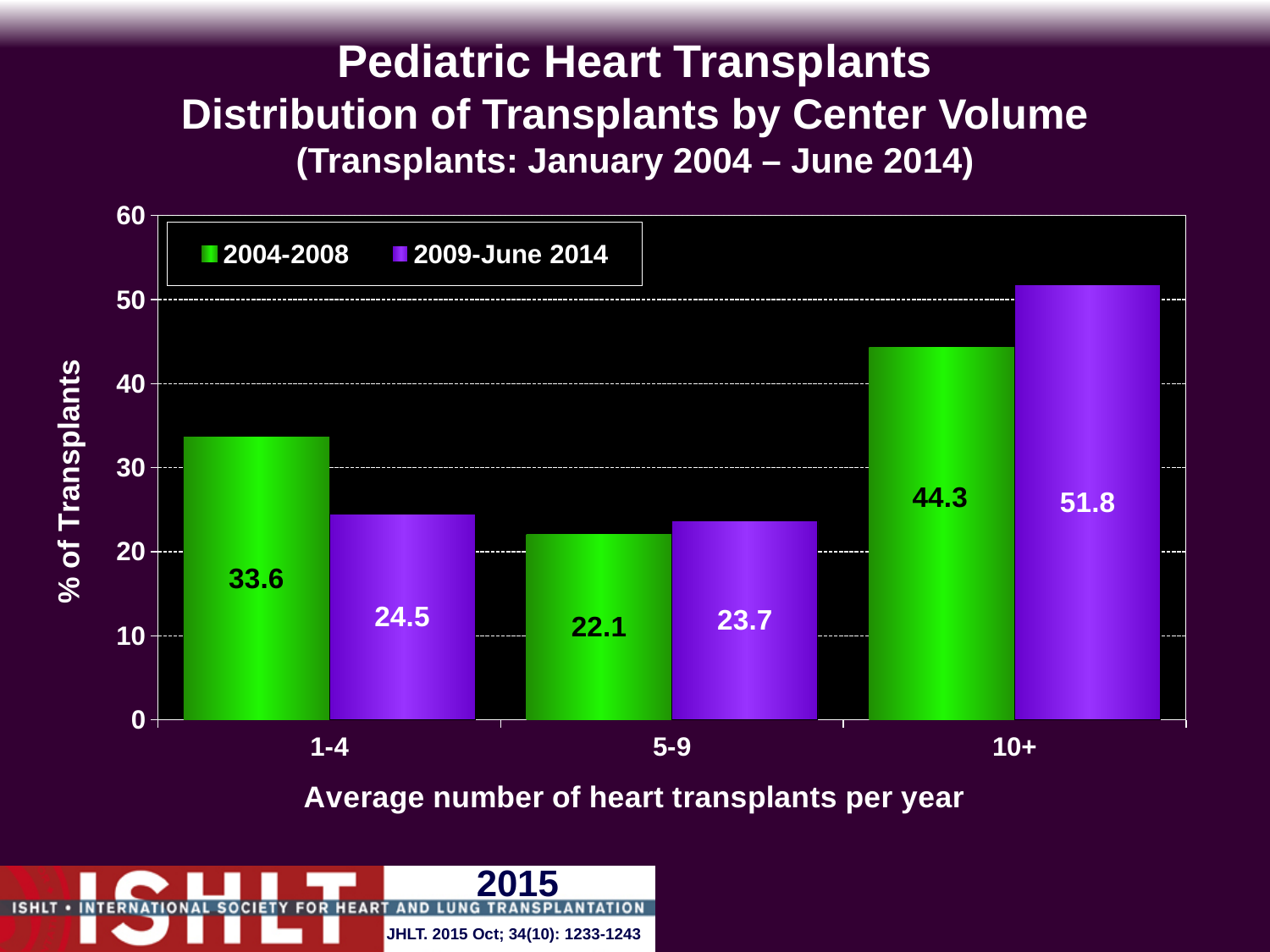
What is the value for the 10+ category in the 2009-June 2014 series? 51.8 Which series has the larger value for the 5-9 category? 2009-June 2014 Which category has the lowest value in the 2009-June 2014 series? 5-9 What is the difference between the 2009-June 2014 and 2004-2008 values for the 10+ category? 7.5 Is the 2009-June 2014 value for the 10+ category greater or less than 50? greater Which category has the highest value in the 2004-2008 series? 10+ What kind of chart is shown on the slide? bar chart What is the value for the 1-4 category in the 2004-2008 series? 33.6 What is the value for the 5-9 category in the 2009-June 2014 series? 23.7 How many series does the legend list? 2 What is the difference between the 2004-2008 and 2009-June 2014 values for the 1-4 category? 9.1 How many categories are shown on the x axis? 3